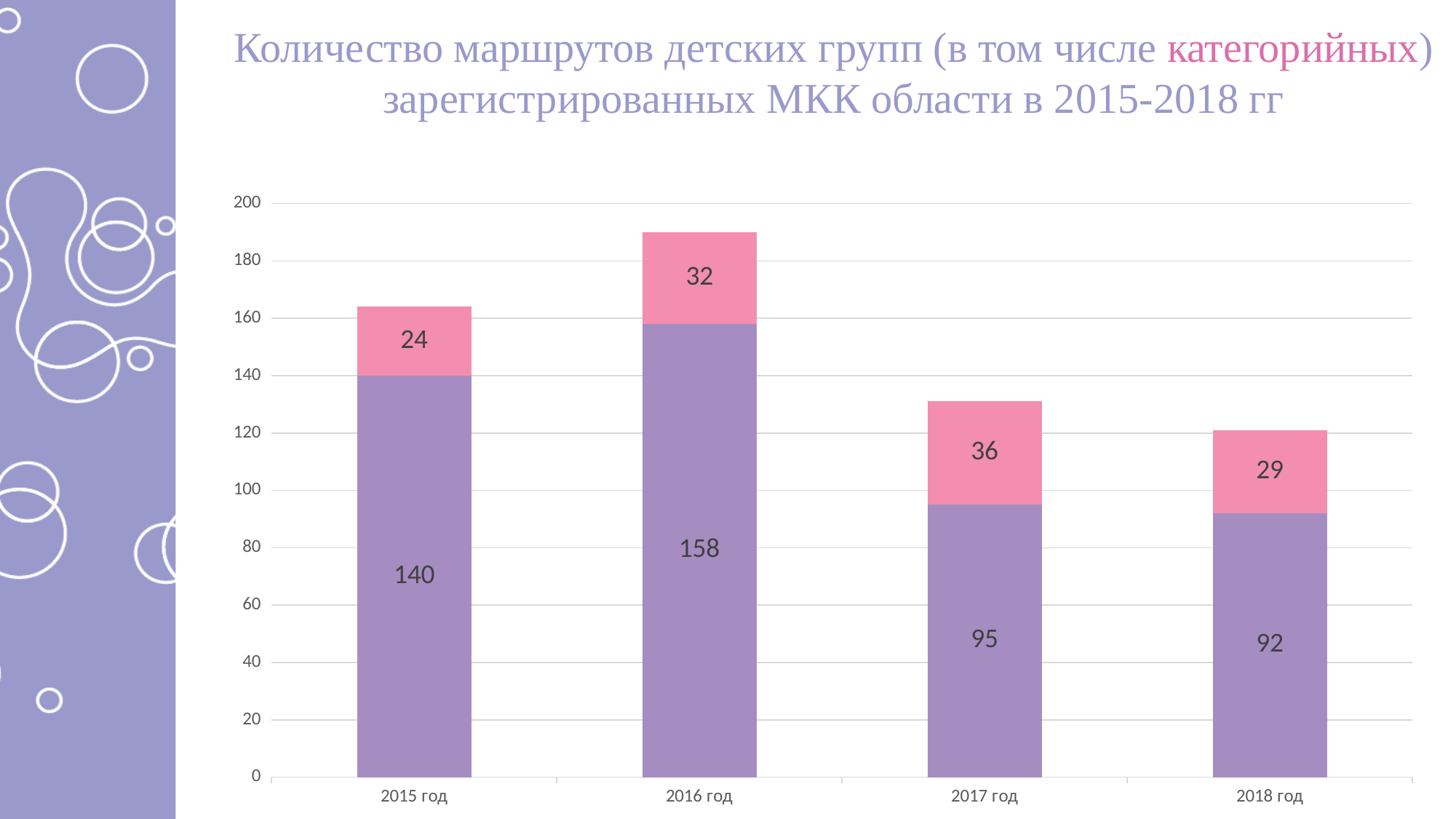
What is the value of the pink segment for 2015 год? 24 What is the total of the stacked bar for 2018 год? 121 What is the difference between the purple segment values for 2015 год and 2018 год? 48 What type of chart is shown on the slide? Stacked bar chart What is the value of the pink segment for 2017 год? 36 What is the total of the stacked bar for 2016 год? 190 Which year has the lowest value in the pink segment? 2015 год How many years (categories) are shown on the x axis? 4 Which year has the highest value in the purple segment? 2016 год What is the value of the purple segment for 2016 год? 158 Which colour represents the категорийных routes in the chart? Pink Which is larger: the pink segment for 2016 год or the pink segment for 2018 год? 2016 год